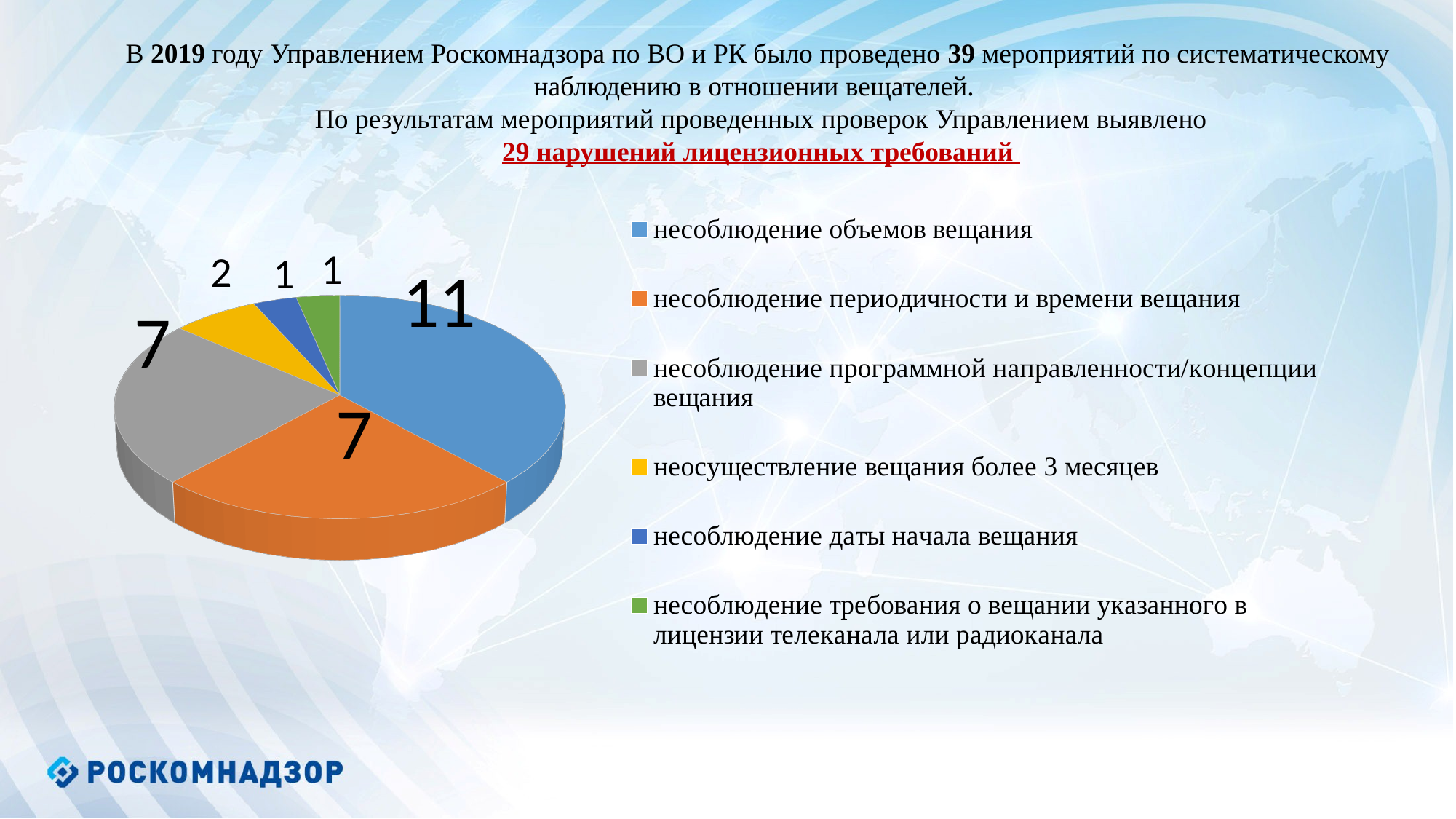
Which category has the largest slice in the pie chart? несоблюдение объемов вещания What is the value for "несоблюдение периодичности и времени вещания" in the pie chart? 7 How many slices does the pie chart have? 6 What is the value for "несоблюдение объемов вещания" in the pie chart? 11 What colour is the slice for "несоблюдение требования о вещании указанного в лицензии телеканала или радиоканала"? green How many entries does the legend of the pie chart list? 6 What is the difference between the values for "несоблюдение объемов вещания" and "несоблюдение программной направленности/концепции вещания"? 4 What is the total of all the slice values in the pie chart? 29 What kind of chart is shown on the slide? pie chart Which is larger: the value for "неосуществление вещания более 3 месяцев" or the value for "несоблюдение даты начала вещания"? неосуществление вещания более 3 месяцев What is the value for "неосуществление вещания более 3 месяцев" in the pie chart? 2 What is the value for "несоблюдение даты начала вещания" in the pie chart? 1